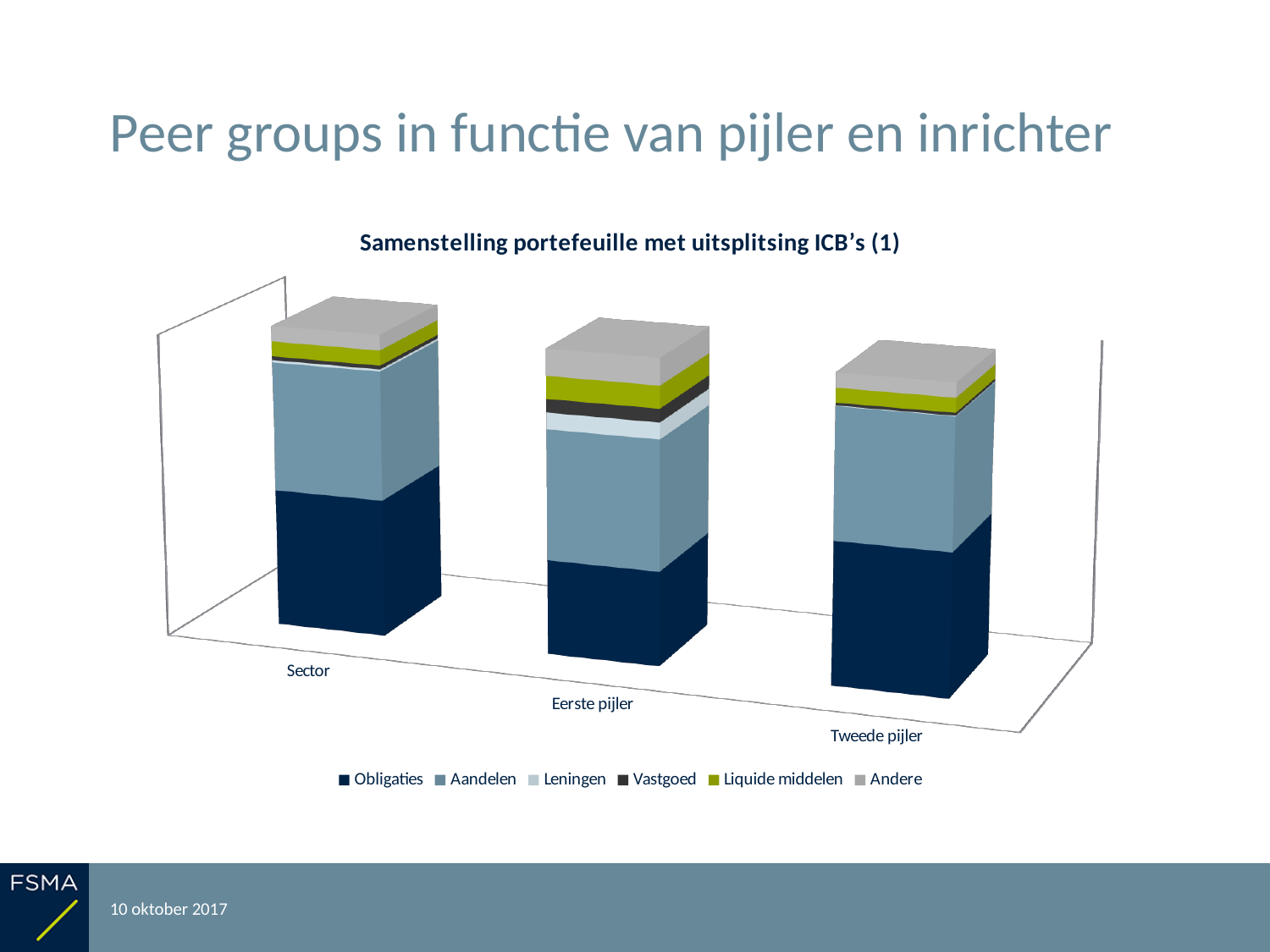
Which category has the largest Leningen segment in its bar? Eerste pijler Which category has the largest Vastgoed segment in its bar? Eerste pijler In the Eerste pijler bar, which segment is larger: Obligaties or Aandelen? Aandelen Which category label appears furthest to the right on the x axis? Tweede pijler What kind of chart is shown on the slide? Stacked bar chart What is the title of the chart? Samenstelling portefeuille met uitsplitsing ICB’s (1) Which series forms the bottom segment of each stacked bar? Obligaties How many categories (bars) are shown on the x axis of the chart? 3 How many series does the chart legend list? 6